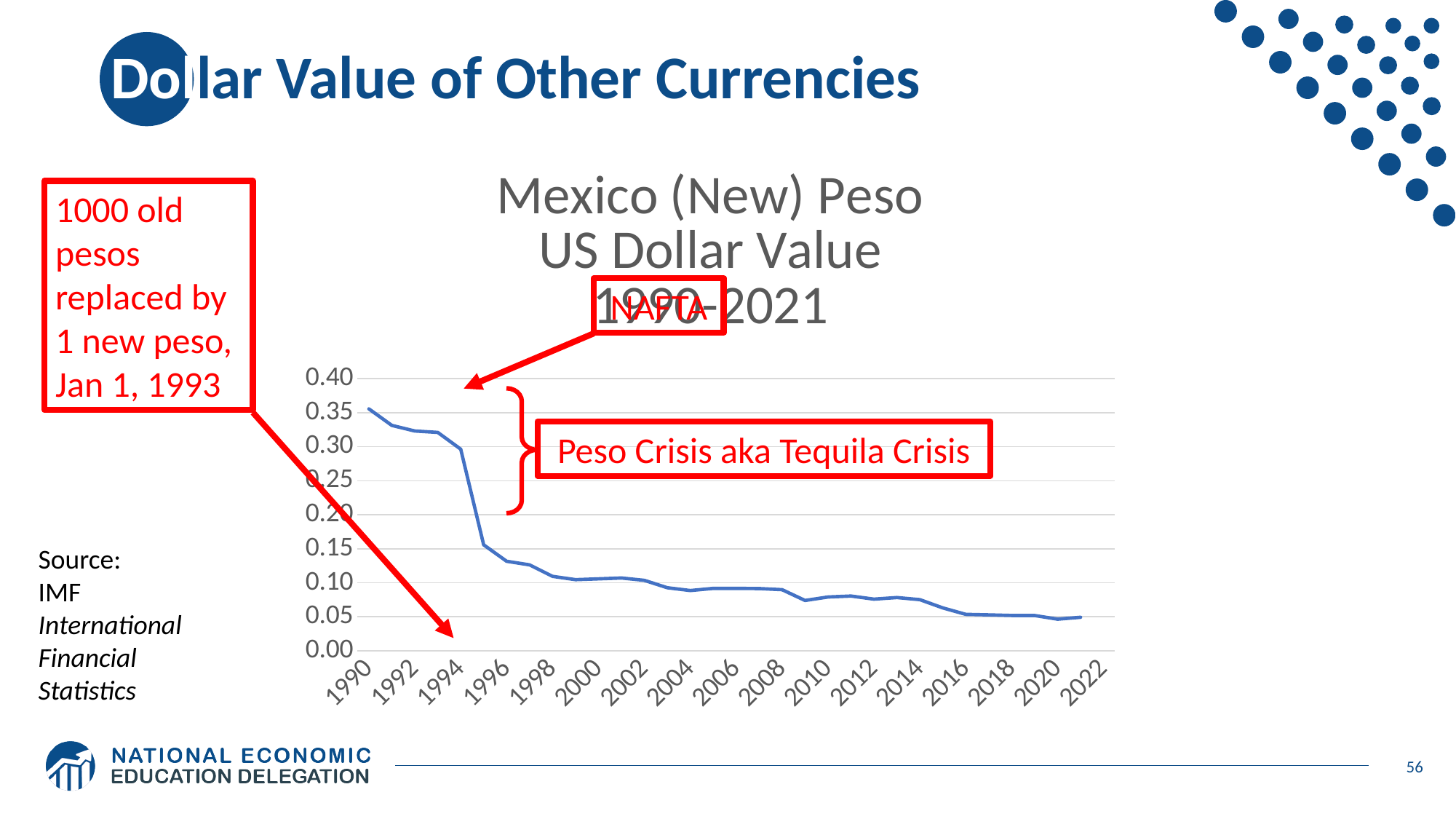
Is the value for 1990 greater or less than 0.30? greater What is the highest value shown on the y axis? 0.40 Does the US dollar value of the Mexican peso rise or fall from 1990 to 2021? fall What is the title of the chart? Mexico (New) Peso US Dollar Value 1990-2021 Which year has the highest US dollar value of the peso on the chart? 1990 Is the value for 2010 greater or less than 0.10? less Which is larger, the value for 1994 or the value for 1996? 1994 What kind of chart is shown on the slide? line chart Is the value for 2020 greater or less than 0.10? less How many year labels are shown on the x axis? 17 Which is larger, the value for 1990 or the value for 2020? 1990